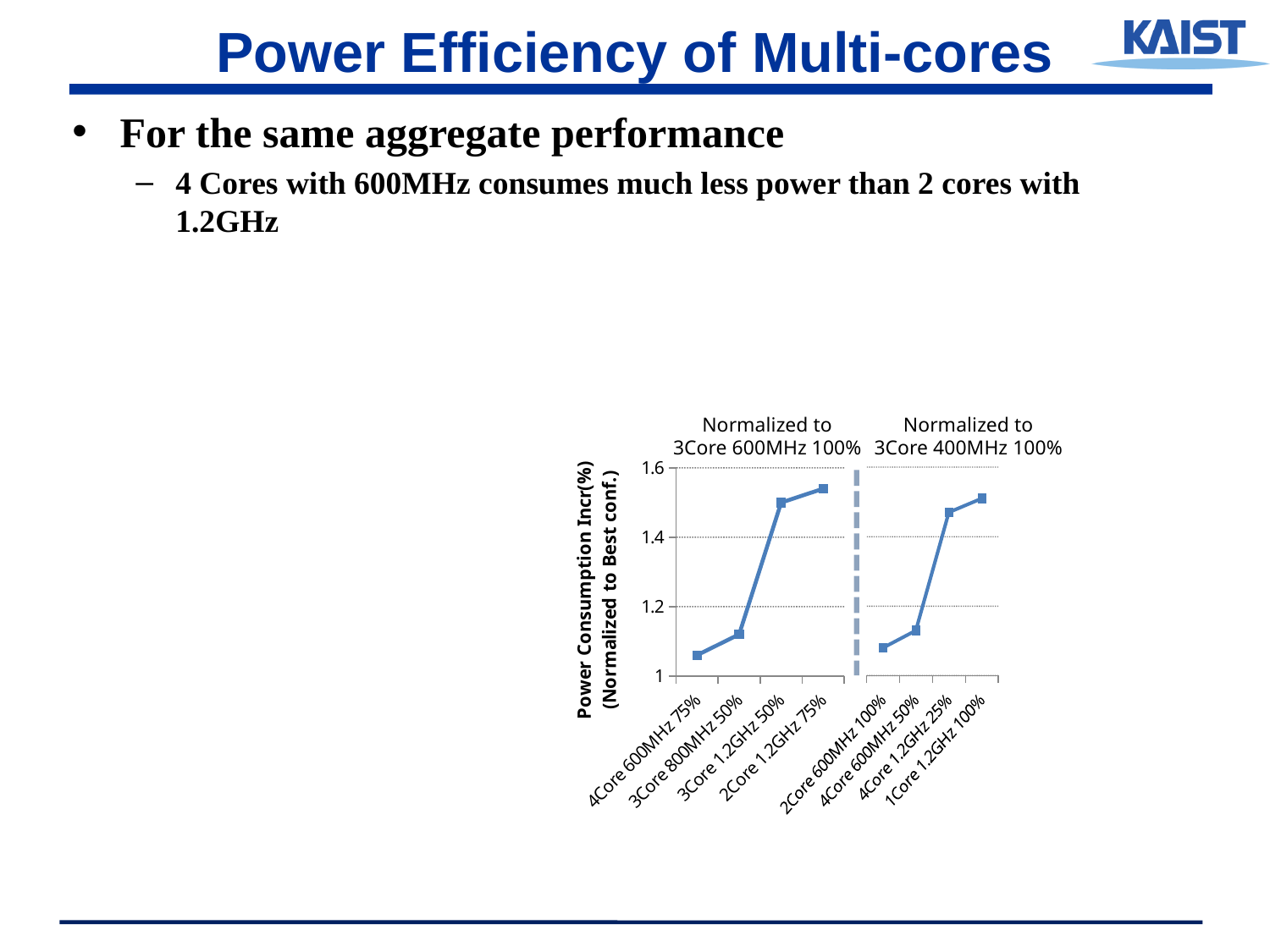
Is the value for 4Core 1.2GHz 25% greater or less than 1.4? greater Is the value for 4Core 600MHz 50% greater or less than 1.2? less What kind of chart is shown on the slide? line chart Is the value for 1Core 1.2GHz 100% greater or less than 1.4? greater According to the label above the left group of the chart, what configuration are those values normalized to? 3Core 600MHz 100% How many categories are plotted along the x axis of the chart? 8 Which has the larger value, 3Core 800MHz 50% or 3Core 1.2GHz 50%? 3Core 1.2GHz 50% Which has the larger value, 4Core 600MHz 75% or 2Core 1.2GHz 75%? 2Core 1.2GHz 75% What is the y-axis title of the chart? Power Consumption Incr(%) (Normalized to Best conf.) Within the left group of the chart (from 4Core 600MHz 75% to 2Core 1.2GHz 75%), do the values rise or fall along the x axis? rise